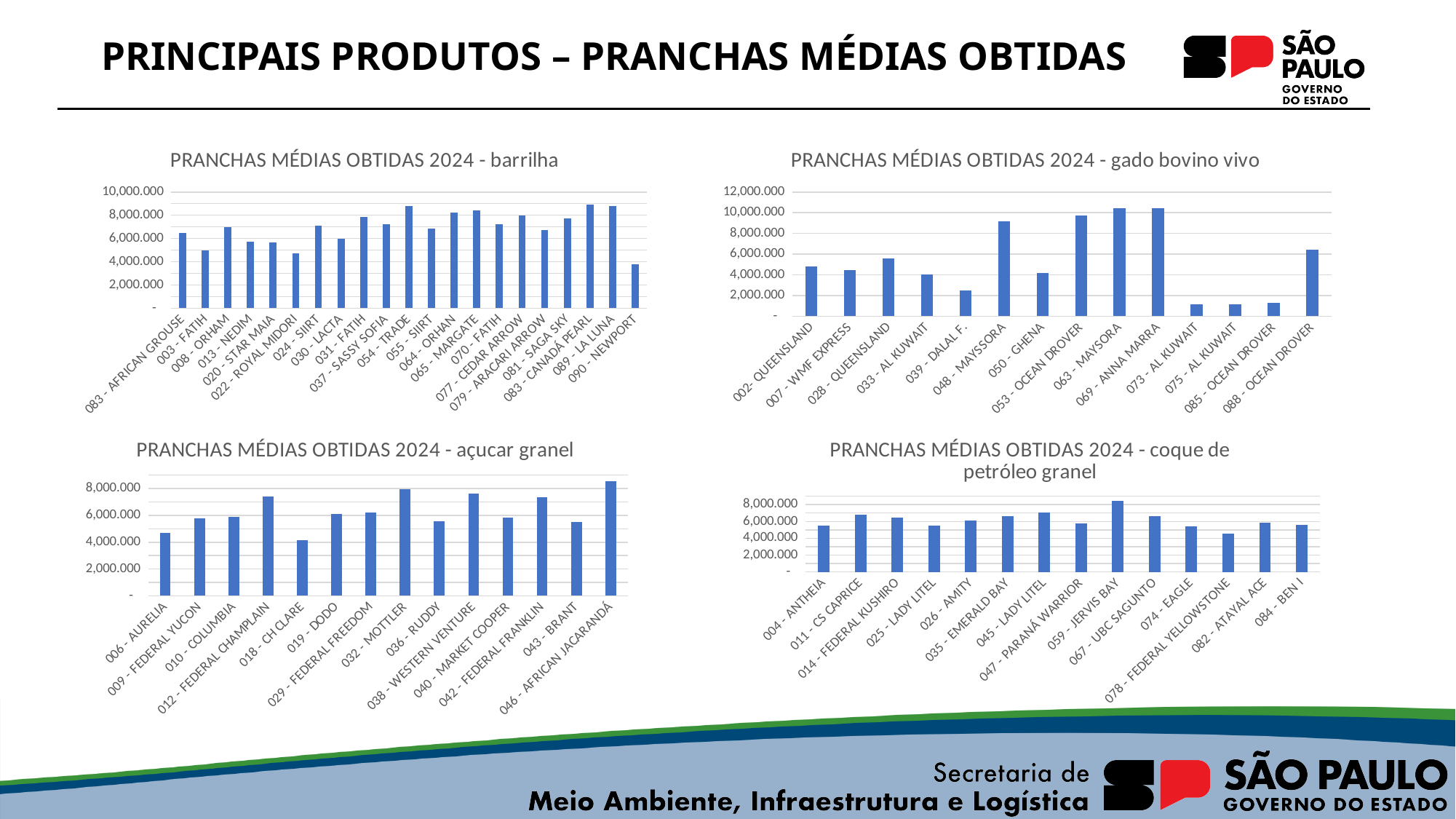
In the chart 'PRANCHAS MÉDIAS OBTIDAS 2024 - gado bovino vivo', is the value for 048 - MAYSSORA greater or less than 8,000.000? greater In the chart 'PRANCHAS MÉDIAS OBTIDAS 2024 - barrilha', how many categories are plotted? 21 In the chart 'PRANCHAS MÉDIAS OBTIDAS 2024 - açucar granel', which category has the highest value? 046 - AFRICAN JACARANDÁ In the chart 'PRANCHAS MÉDIAS OBTIDAS 2024 - barrilha', is the value for 022 - ROYAL MIDORI greater or less than 6,000.000? less How many charts are shown on the slide? 4 In the chart 'PRANCHAS MÉDIAS OBTIDAS 2024 - barrilha', which category has the lowest value? 090 - NEWPORT In the chart 'PRANCHAS MÉDIAS OBTIDAS 2024 - gado bovino vivo', which is larger, the value for 053 - OCEAN DROVER or 088 - OCEAN DROVER? 053 - OCEAN DROVER In the chart 'PRANCHAS MÉDIAS OBTIDAS 2024 - coque de petróleo granel', which category has the highest value? 059 - JERVIS BAY In the chart 'PRANCHAS MÉDIAS OBTIDAS 2024 - barrilha', what kind of chart is used? bar chart In the chart 'PRANCHAS MÉDIAS OBTIDAS 2024 - coque de petróleo granel', is the value for 078 - FEDERAL YELLOWSTONE greater or less than 6,000.000? less In the chart 'PRANCHAS MÉDIAS OBTIDAS 2024 - gado bovino vivo', how many categories are plotted? 14 In the chart 'PRANCHAS MÉDIAS OBTIDAS 2024 - açucar granel', which category has the lowest value? 018 - CH CLARE